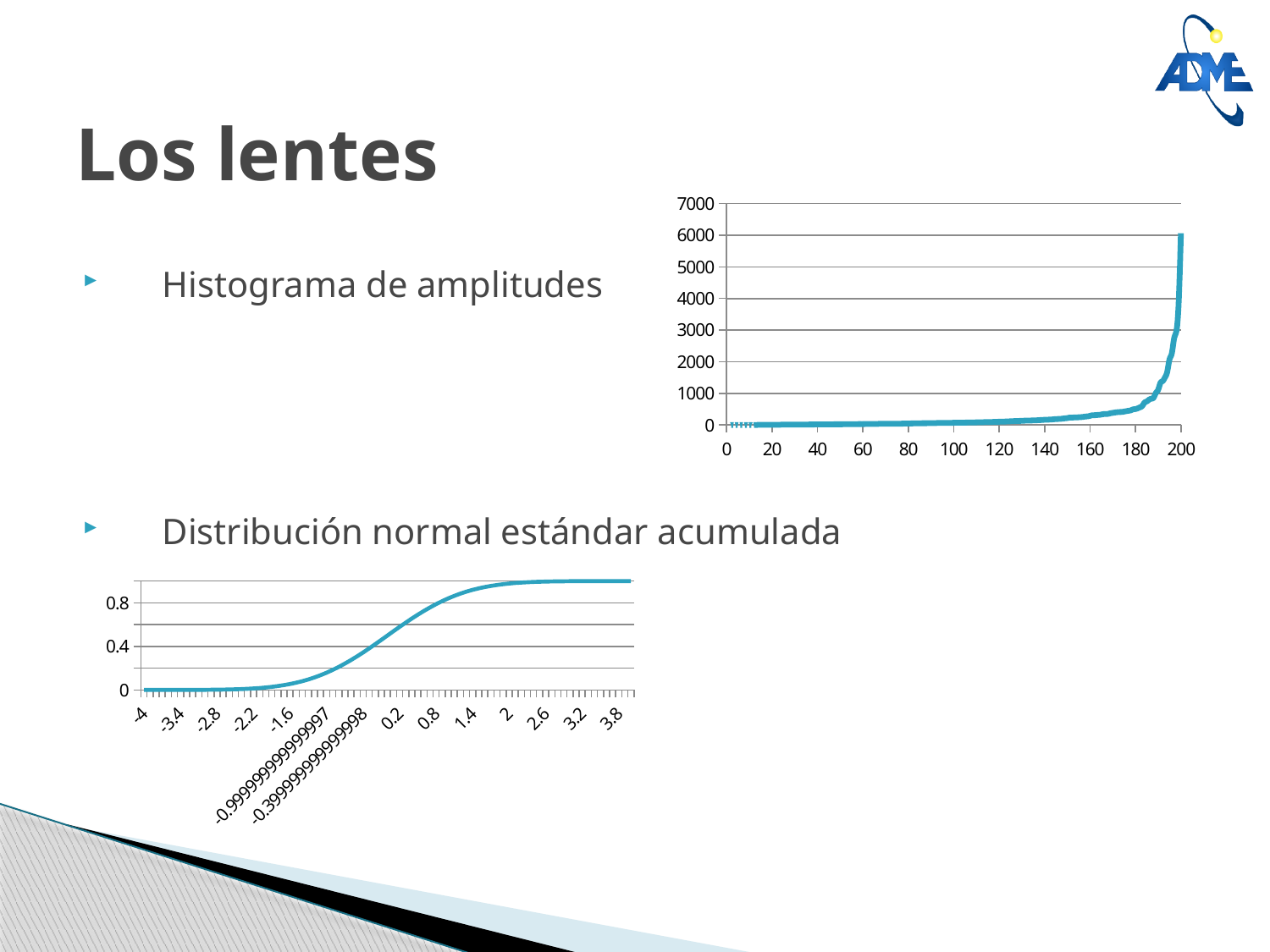
In the 'Histograma de amplitudes' chart, is the value at x = 100 greater or less than 1000? less In the 'Histograma de amplitudes' chart, do the values rise or fall as the x axis goes from 0 to 200? rise What kind of chart is the 'Histograma de amplitudes' chart at the top right of the slide? line chart What is the highest tick shown on the y axis of the 'Histograma de amplitudes' chart? 7000 In the 'Histograma de amplitudes' chart, is the value at x = 200 greater or less than 5000? greater In the 'Histograma de amplitudes' chart, is the value at x = 160 greater or less than 2000? less What is the rightmost x-axis label on the 'Distribución normal estándar acumulada' chart? 3.8 In the 'Distribución normal estándar acumulada' chart, do the values rise or fall as the x axis goes from -4 to 3.8? rise What kind of chart is the 'Distribución normal estándar acumulada' chart at the bottom of the slide? line chart